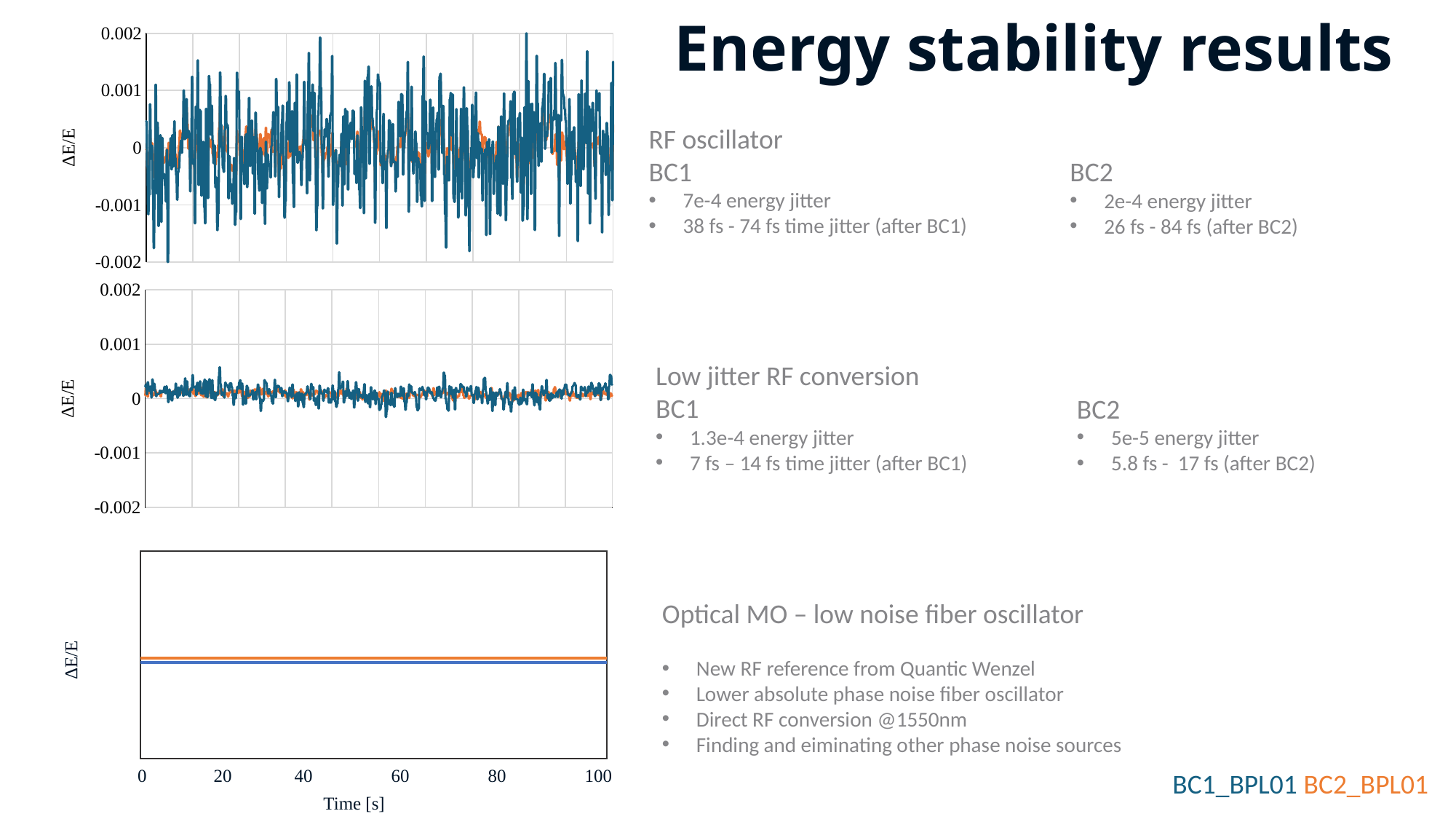
In the top chart, does the blue BC1_BPL01 series rise above 0.001 at any point? Yes What is the maximum value shown on the y-axis of the top chart? 0.002 In the top chart, which series shows larger fluctuations, BC1_BPL01 (blue) or BC2_BPL01 (orange)? BC1_BPL01 How many series does the legend at the bottom right of the slide list? 2 What is the minimum value shown on the y-axis of the middle chart? -0.002 What kind of chart is the top chart on the slide? Line chart In the middle chart, does the blue BC1_BPL01 series ever rise above 0.001? No What is the y-axis label of the top chart? ΔE/E How many charts are shown on the slide? 3 What is the largest tick value shown on the x-axis of the bottom chart? 100 What is the x-axis label of the bottom chart? Time [s] What are the two series names shown in the legend at the bottom right of the slide? BC1_BPL01 and BC2_BPL01